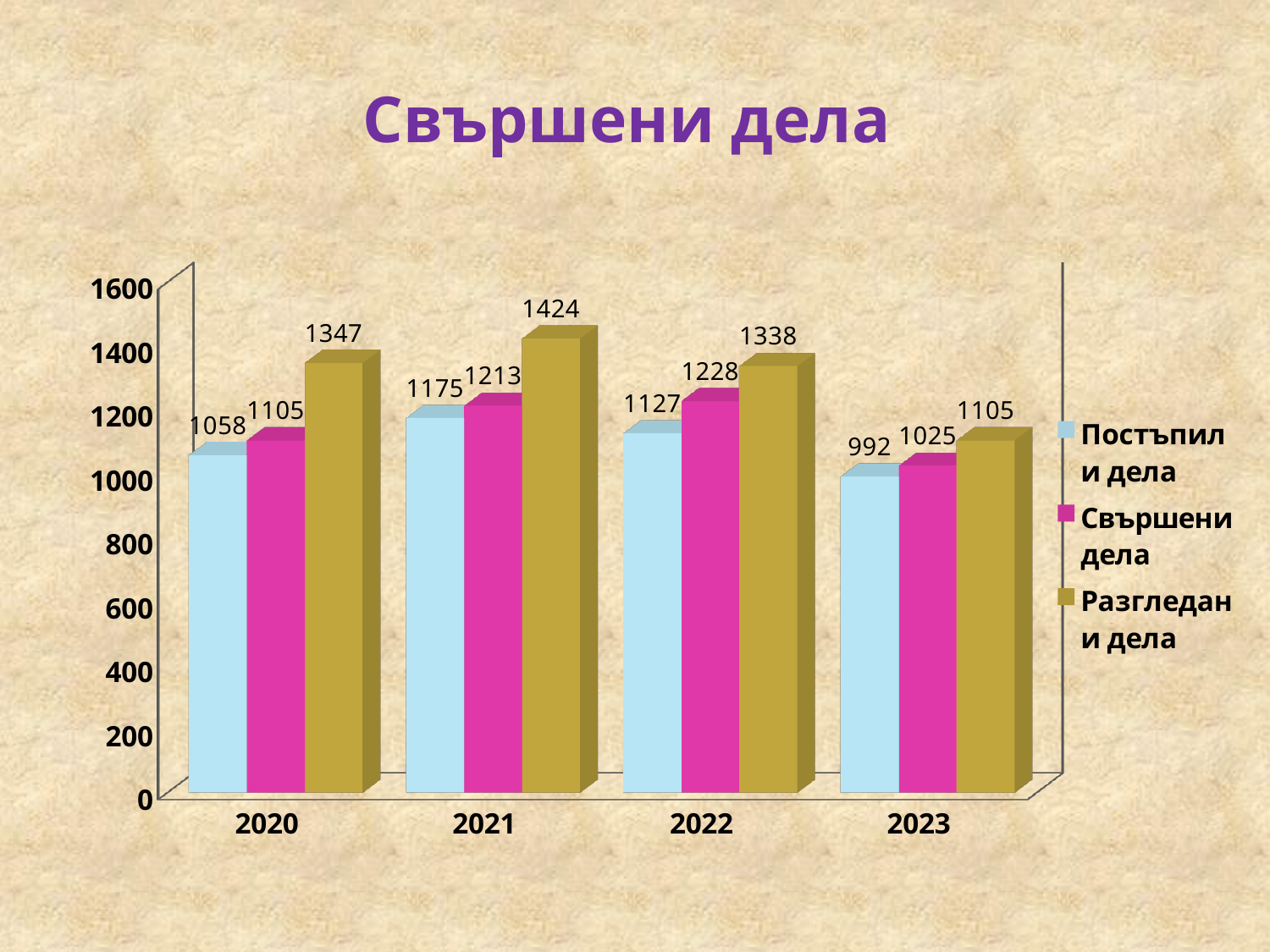
How many years are shown on the x axis? 4 In which year is Постъпили дела lowest? 2023 What is the value for Разгледани дела in 2022? 1338 Is the value for Разгледани дела in 2021 greater or less than 1400? greater What kind of chart is shown? bar chart What is the value for Постъпили дела in 2023? 992 What is the title of the chart? Свършени дела Which is larger in 2022: Свършени дела or Постъпили дела? Свършени дела What is the difference between Разгледани дела and Постъпили дела in 2020? 289 What is the value for Свършени дела in 2021? 1213 In which year is Разгледани дела highest? 2021 How many series does the legend list? 3